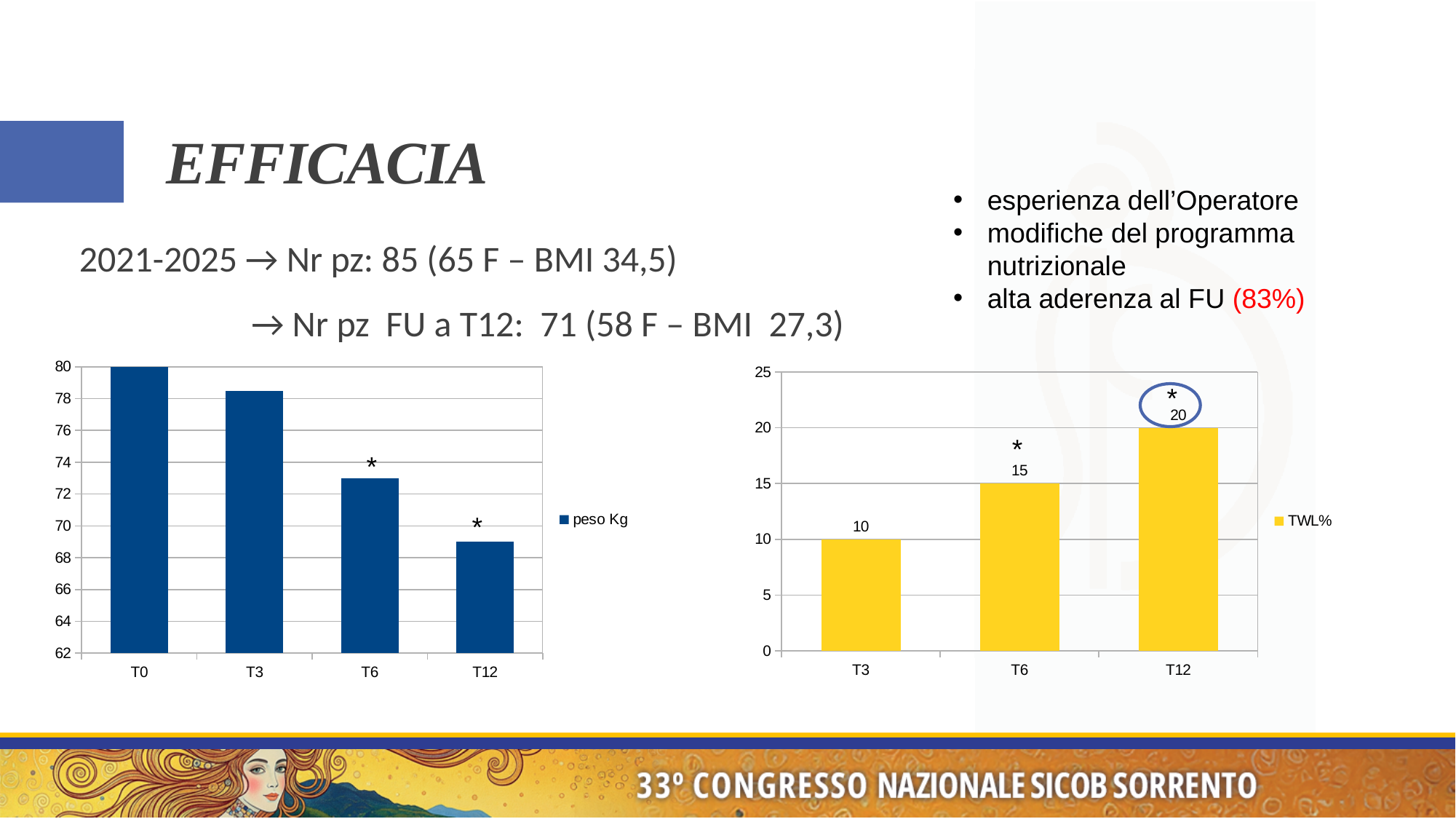
In the left chart (peso Kg), do the values rise or fall from T0 to T12? fall In the right chart (TWL%), what is the value for T3? 10 In the right chart (TWL%), what is the value for T6? 15 In the right chart (TWL%), which time point has the highest value? T12 How many time points are shown in the left chart (peso Kg)? 4 In the right chart (TWL%), what is the value for T12? 20 In the left chart (peso Kg), is the value for T6 greater or less than 74? less In the left chart (peso Kg), is the value for T12 greater or less than 68? greater In the right chart (TWL%), what is the difference between the values at T12 and T3? 10 What type of chart is the right chart (TWL%)? bar chart In the left chart (peso Kg), which time point has the lowest value? T12